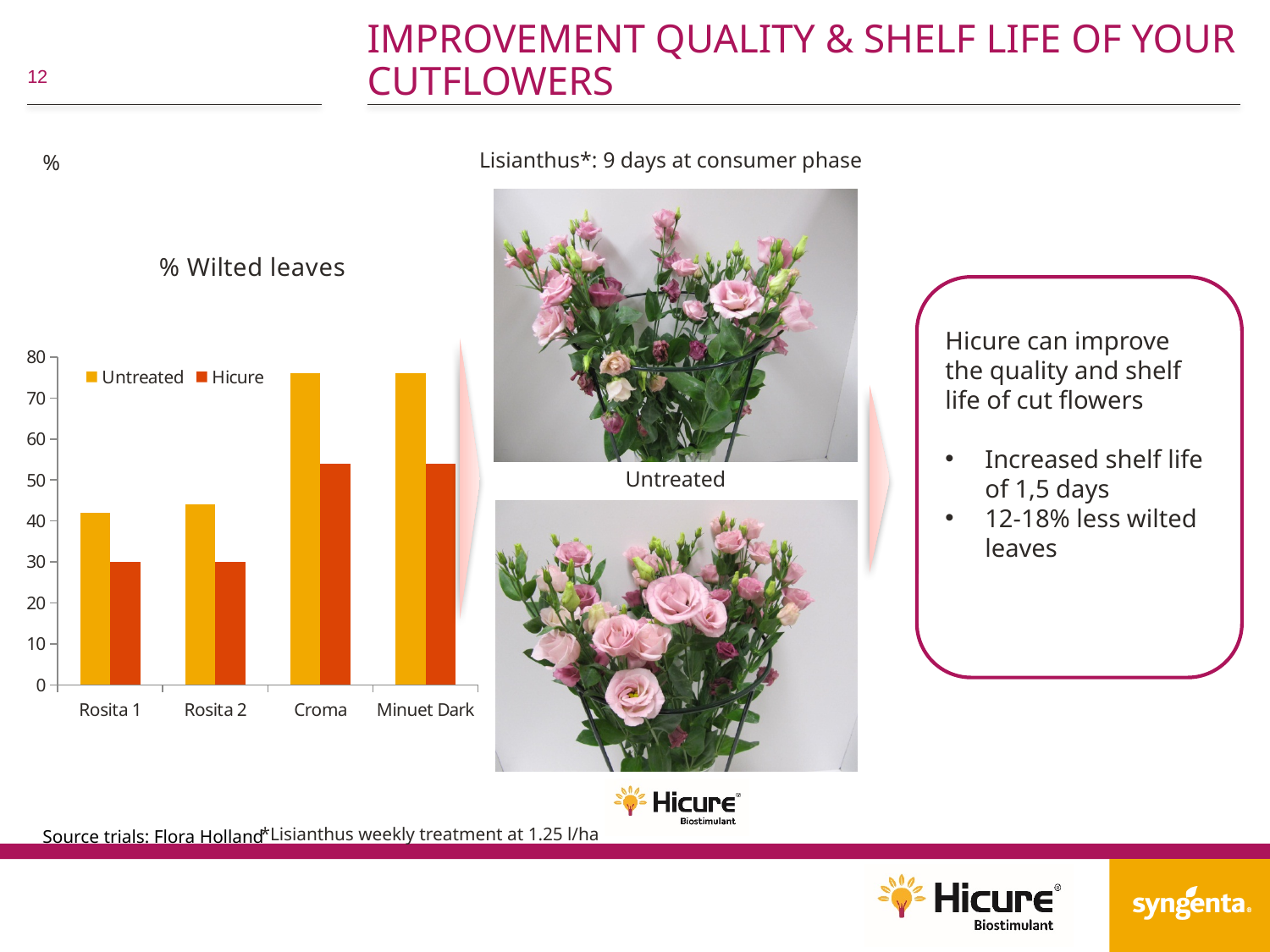
How many categories are shown on the x axis of the chart? 4 For Rosita 1, which is larger: the Untreated value or the Hicure value? Untreated Is the Hicure value for Minuet Dark greater or less than 50? greater Is the Hicure value for Rosita 2 greater or less than 40? less What type of chart is shown on the slide? bar chart For Croma, which is larger: the Untreated value or the Hicure value? Untreated Is the Untreated value for Rosita 1 greater or less than 50? less How many series does the chart legend list? 2 Which is larger: the Untreated value for Croma or the Untreated value for Rosita 2? Croma Which two series are listed in the chart legend? Untreated and Hicure What is the title of the chart? % Wilted leaves